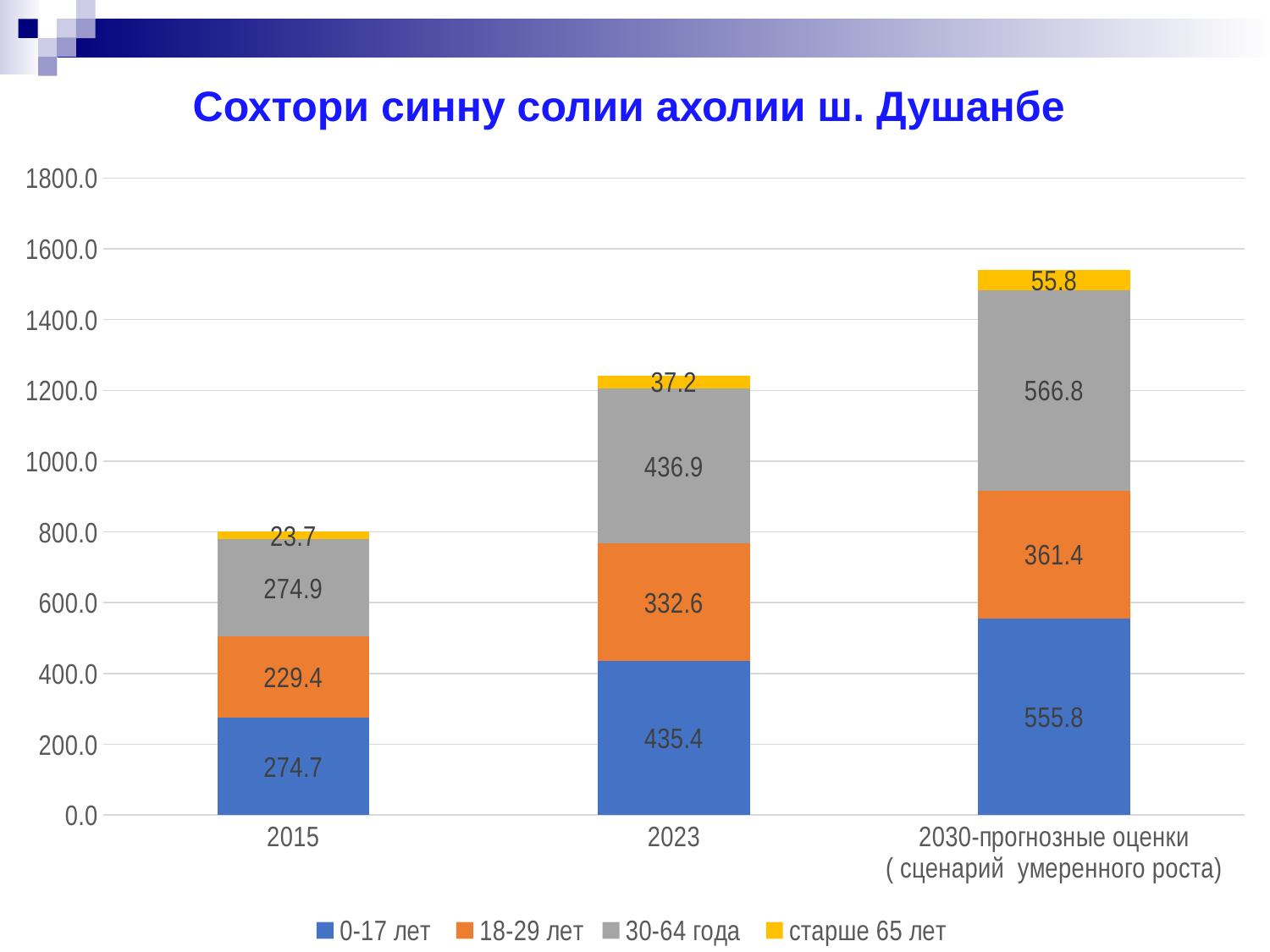
What is the value for the 0-17 лет series in 2023? 435.4 What is the value for the 30-64 года series in the 2030 forecast category? 566.8 What is the difference between the 0-17 лет values for 2030 and 2015? 281.1 Which is larger in 2023: the 18-29 лет value or the 30-64 года value? 30-64 года What type of chart is shown on the slide? Stacked bar chart Which category has the lowest value for the 30-64 года series? 2015 Which category has the highest value for the 18-29 лет series? 2030-прогнозные оценки (сценарий умеренного роста) What is the value for the старше 65 лет series in 2015? 23.7 What is the total of the stacked bar for 2015? 802.7 How many series does the legend list? 4 Do the total bar heights rise or fall from 2015 to the 2030 forecast? Rise How many categories are shown on the x axis? 3